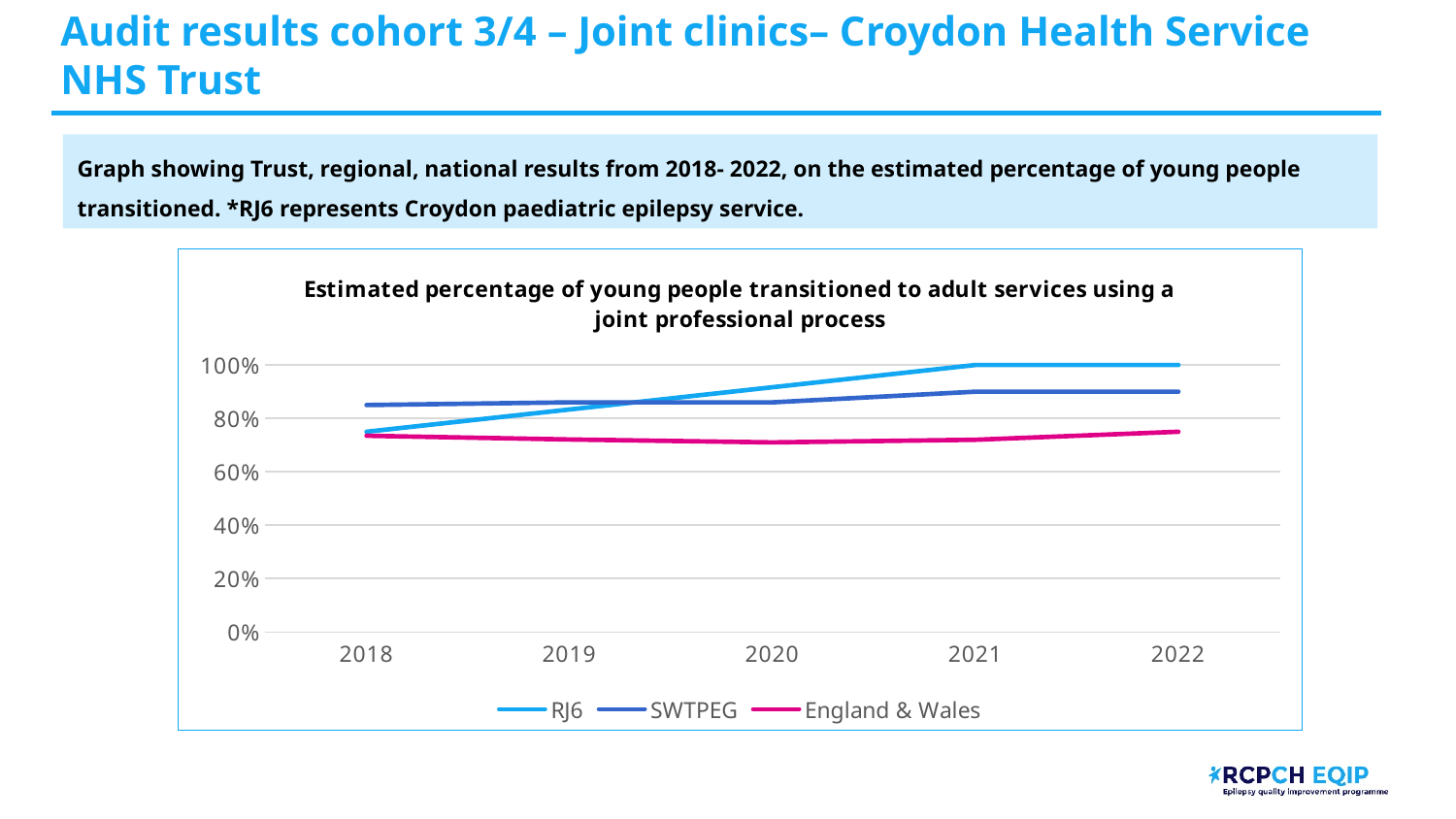
Which series is drawn in pink/magenta in the legend? England & Wales Is the value for SWTPEG in 2018 greater or less than 80%? greater Does the RJ6 line rise or fall from 2018 to 2022? Rise Which series has the highest value in 2022? RJ6 What kind of chart is shown on the slide? Line chart Is the value for RJ6 in 2018 greater or less than 80%? less What is the value for RJ6 in 2022? 100% Is the value for England & Wales in 2022 greater or less than 80%? less In 2018, which is larger: the value for RJ6 or the value for SWTPEG? SWTPEG Which series has the lowest value in 2020? England & Wales How many years are shown on the x axis? 5 How many series does the legend list? 3